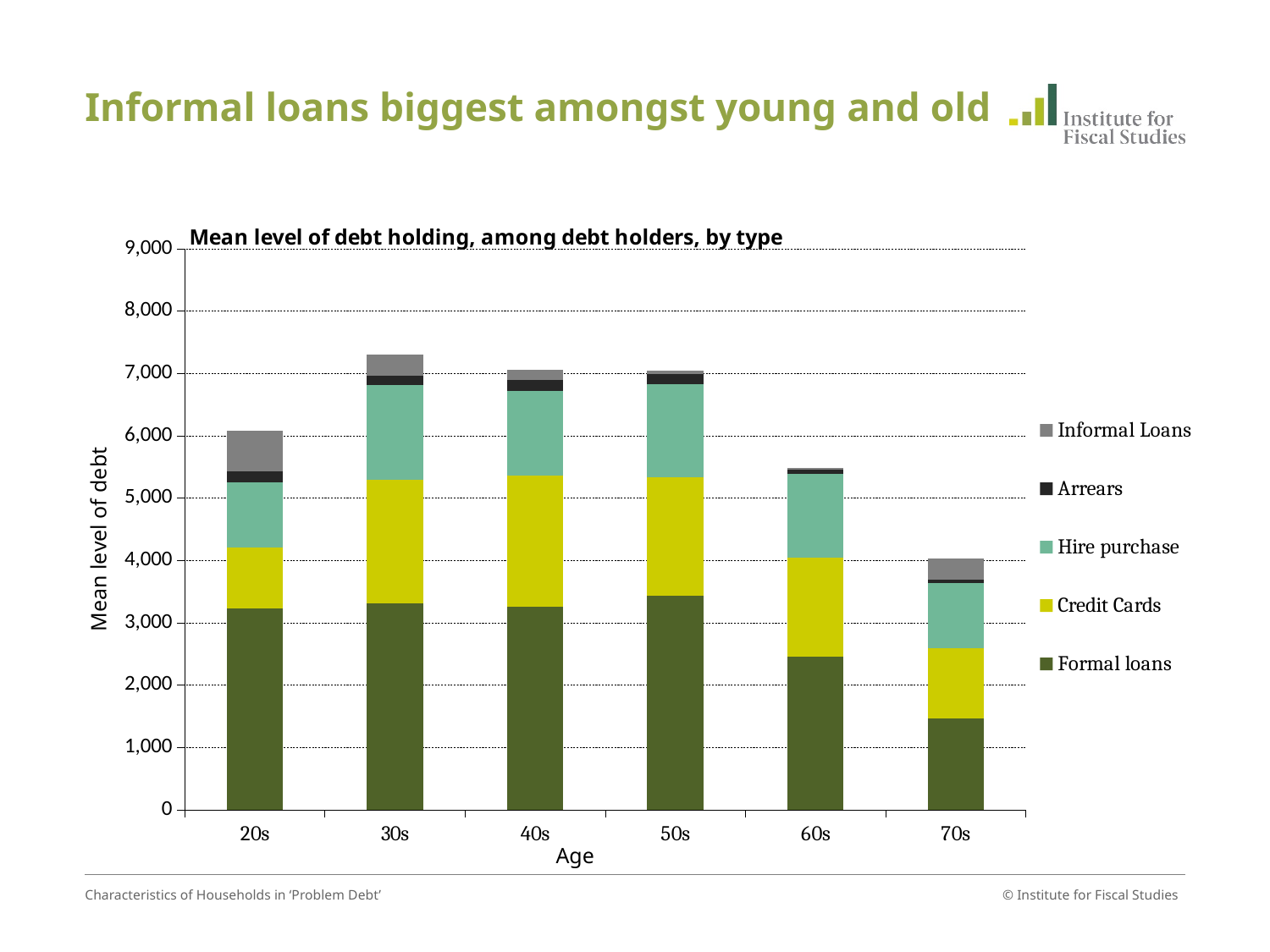
Which age group has the highest total mean level of debt? 30s Is the total mean level of debt for the 30s age group greater or less than 7,000? greater Is the Formal loans value for the 70s age group greater or less than 2,000? less How many series does the legend list? 5 Is the total mean level of debt for the 70s age group greater or less than 5,000? less What kind of chart is shown on the slide? Stacked bar chart How many age groups are shown on the x axis? 6 What is the title of the chart? Mean level of debt holding, among debt holders, by type Which age group has the larger Informal Loans segment, 20s or 50s? 20s Which age group has the lowest total mean level of debt? 70s Which has the larger total mean level of debt, the 60s or the 70s age group? 60s